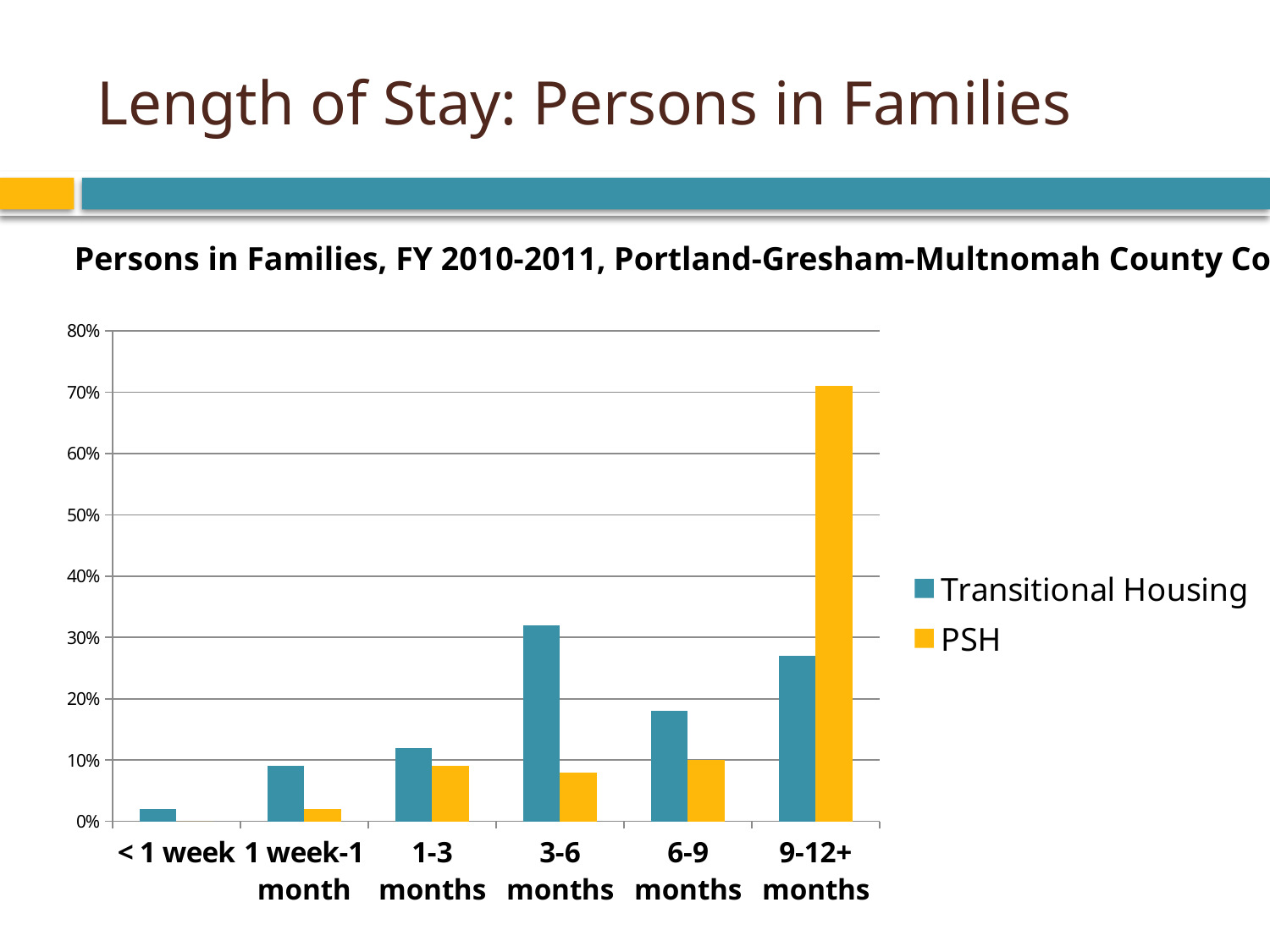
For 6-9 months, which series has the larger value, Transitional Housing or PSH? Transitional Housing How many series does the legend list? 2 Which length-of-stay category has the lowest Transitional Housing value? < 1 week How many length-of-stay categories are shown on the x axis? 6 Which series does the legend list first? Transitional Housing Which length-of-stay category has the highest Transitional Housing value? 3-6 months Is the Transitional Housing value for 3-6 months greater or less than 20%? greater What kind of chart is shown on the slide? bar chart Which length-of-stay category has the highest PSH value? 9-12+ months For 9-12+ months, which series has the larger value, Transitional Housing or PSH? PSH Is the PSH value for 9-12+ months greater or less than 60%? greater